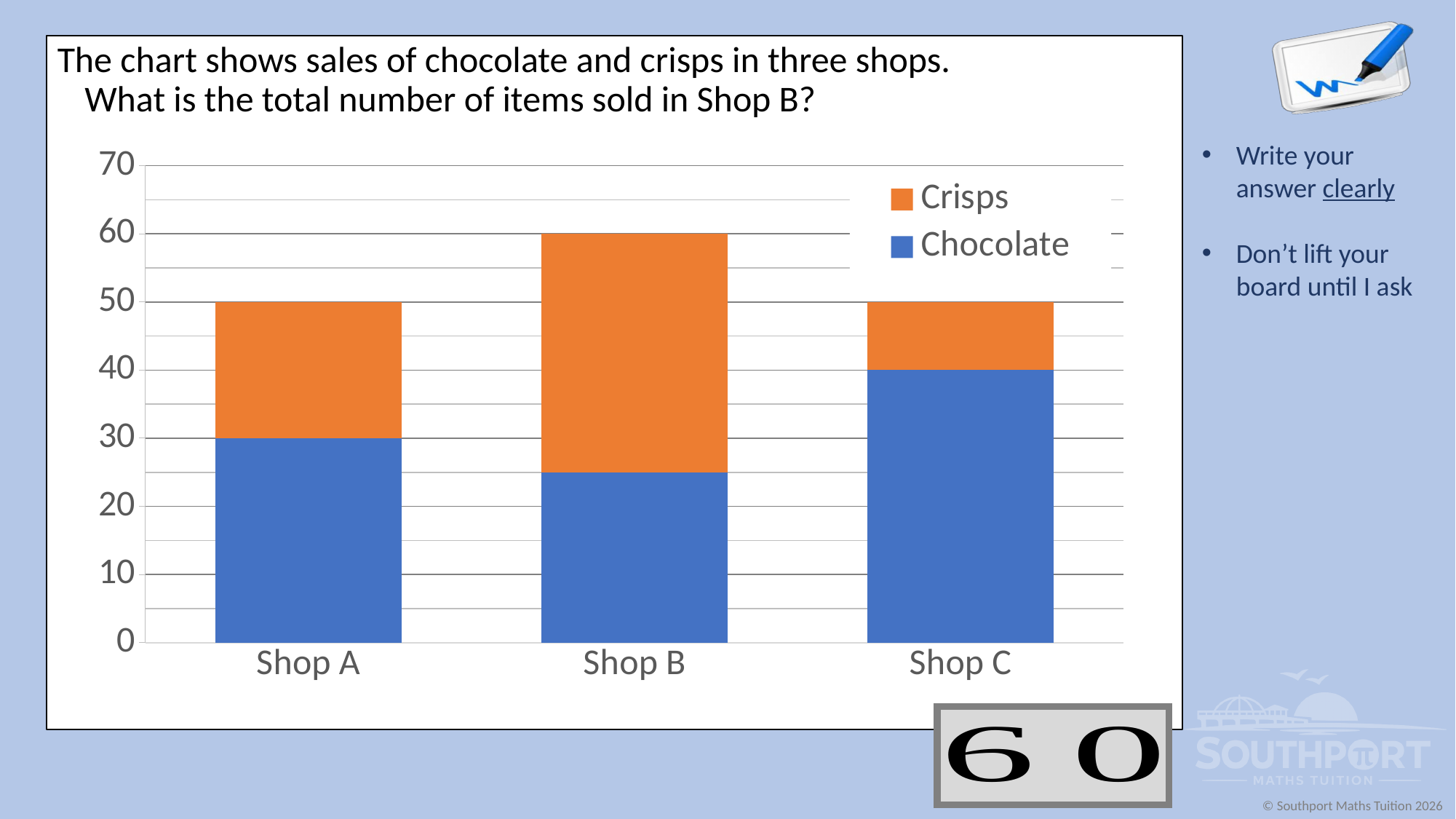
What is the total number of items sold in Shop C? 50 What kind of chart is shown on the slide? stacked bar chart Which shop has the highest total sales? Shop B What is the total number of items sold in Shop A? 50 What is the total number of items sold in Shop B? 60 How many shops are shown on the x axis? 3 Which colour represents Crisps in the chart? orange How many chocolate items were sold in Shop C? 40 How many chocolate items were sold in Shop A? 30 Which shop sold the fewest chocolate items? Shop B Is the number of chocolate items sold in Shop B greater or less than 30? less How many series does the legend list? 2